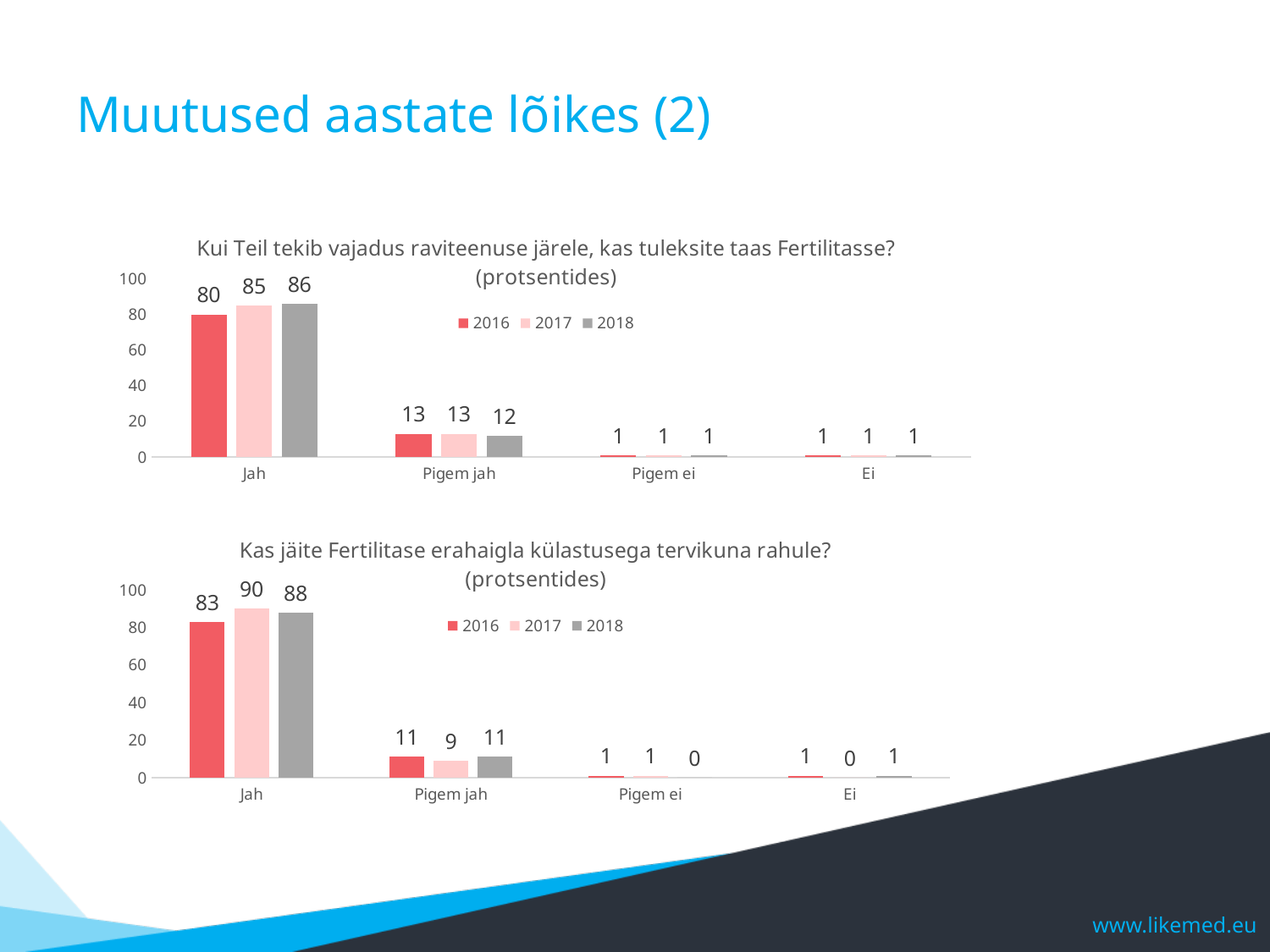
In the bottom chart, which is larger for Pigem jah: the 2016 value or the 2017 value? 2016 In the bottom chart, what is the difference between the 2017 and 2016 values for Jah? 7 In the bottom chart (Kas jäite Fertilitase erahaigla külastusega tervikuna rahule?), what is the value for Jah in 2017? 90 How many categories are shown on the x axis of the bottom chart? 4 In the top chart, what is the value for Pigem jah in 2016? 13 How many series does the legend of the top chart list? 3 What type of chart is the bottom chart? Bar chart In the bottom chart, what is the value for Ei in 2017? 0 In the top chart (Kui Teil tekib vajadus raviteenuse järele...), what is the value for Jah in 2018? 86 In the bottom chart, what is the value for Pigem jah in 2017? 9 In the top chart, what is the difference between the 2018 and 2016 values for Jah? 6 In the top chart, which category has the highest value for 2017? Jah